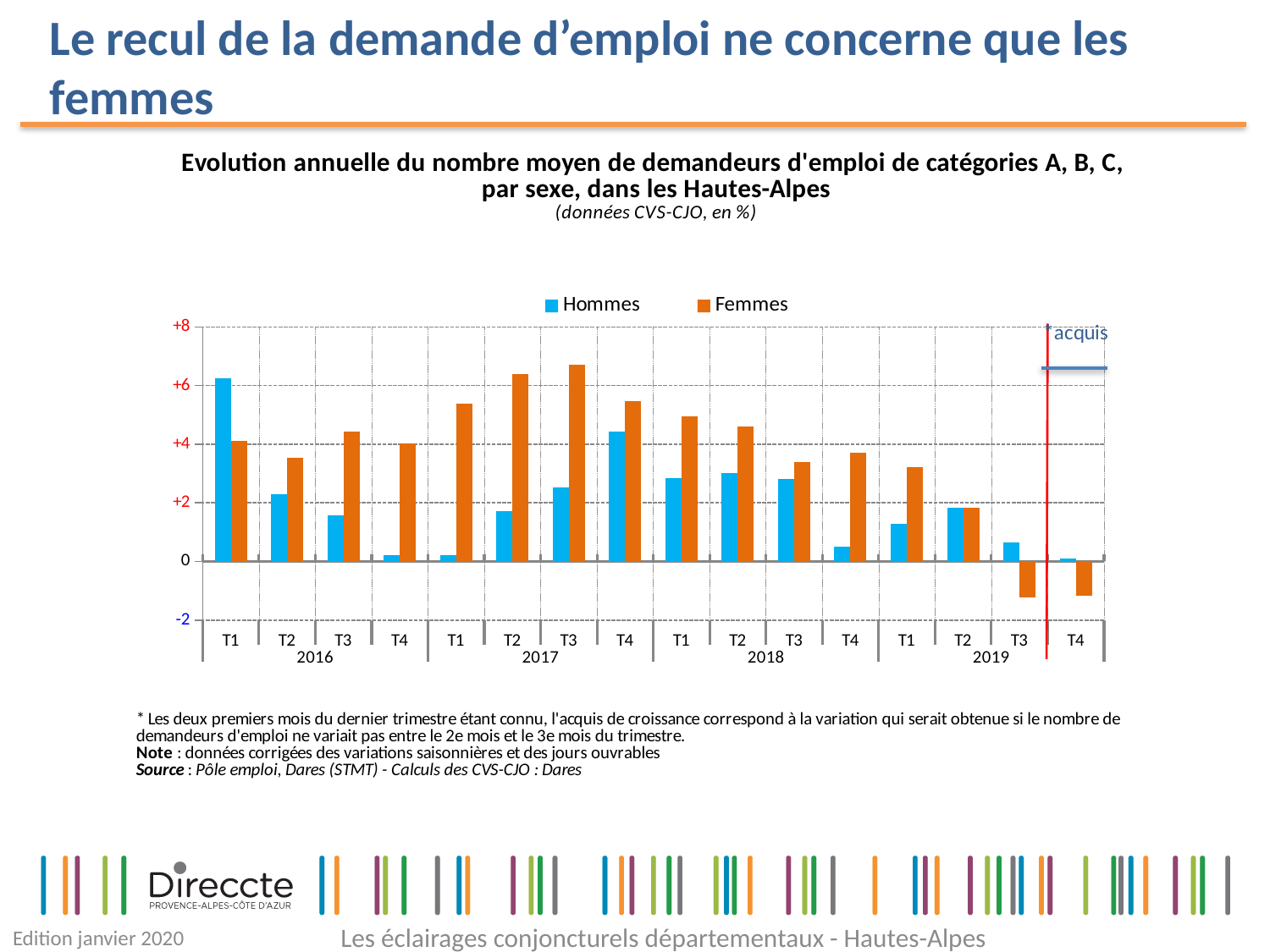
What kind of chart is shown on the slide? bar chart How many series does the legend list? 2 In T3 2017, which series has the larger value, Hommes or Femmes? Femmes Which colour represents the Femmes series in the legend? orange In which quarter is the value for Hommes highest? T1 2016 Is the value for Femmes in T3 2017 greater or less than +6? greater From T3 2017 to T4 2019, do the values for Femmes rise or fall overall? fall Is the value for Femmes in T3 2019 greater or less than 0? less How many quarters (T1–T4 bars groups) are plotted along the x axis? 16 In which quarter is the value for Femmes highest? T3 2017 Is the value for Hommes in T1 2016 greater or less than +6? greater In T1 2016, which series has the larger value, Hommes or Femmes? Hommes